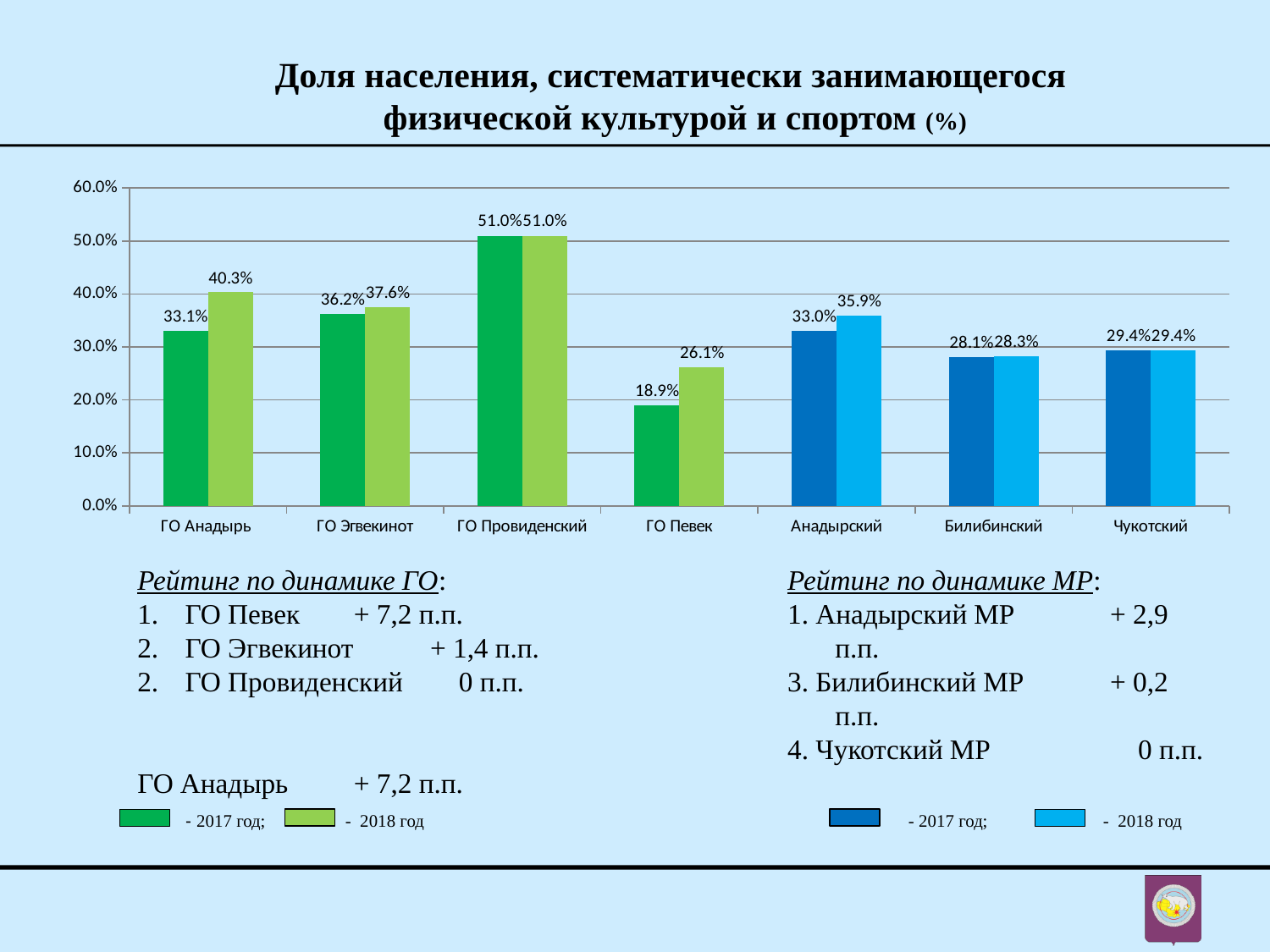
What is the difference between the 2018 and 2017 values for ГО Анадырь? 7.2% How many categories are shown on the x axis? 7 What is the difference between the 2018 and 2017 values for ГО Певек? 7.2% What is the 2017 value for ГО Певек? 18.9% What is the 2018 value for Анадырский? 35.9% What is the 2018 value for ГО Анадырь? 40.3% Which is larger: the 2017 value for ГО Эгвекинот or the 2017 value for Анадырский? ГО Эгвекинот Which category has the lowest 2017 value? ГО Певек How many series (years) does the legend list? 2 What kind of chart is shown on the slide? bar chart Which category has the highest 2018 value? ГО Провиденский Is the 2018 value for Билибинский greater or less than 30.0%? less